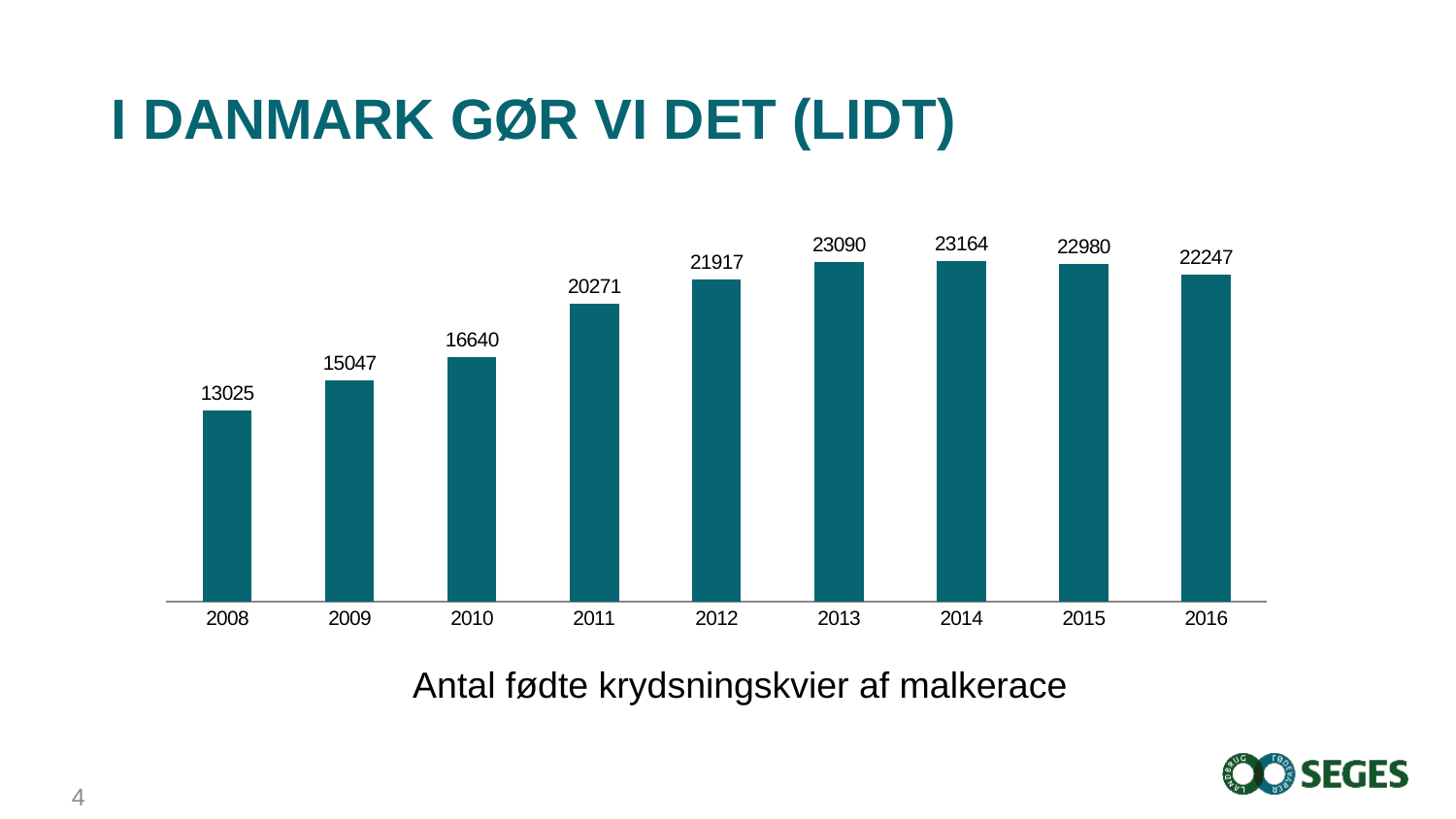
What is the value for 2011? 20271 Which year has the highest value? 2014 Which year has the lowest value? 2008 What is the value for 2016? 22247 What is the difference between the values for 2011 and 2010? 3631 Do the values rise or fall from 2008 to 2013? rise Which is larger, the value for 2012 or the value for 2015? 2015 What is the caption text below the chart? Antal fødte krydsningskvier af malkerace What is the difference between the values for 2016 and 2008? 9222 What kind of chart is shown on the slide? bar chart How many years are shown on the x axis? 9 What is the value for 2008? 13025